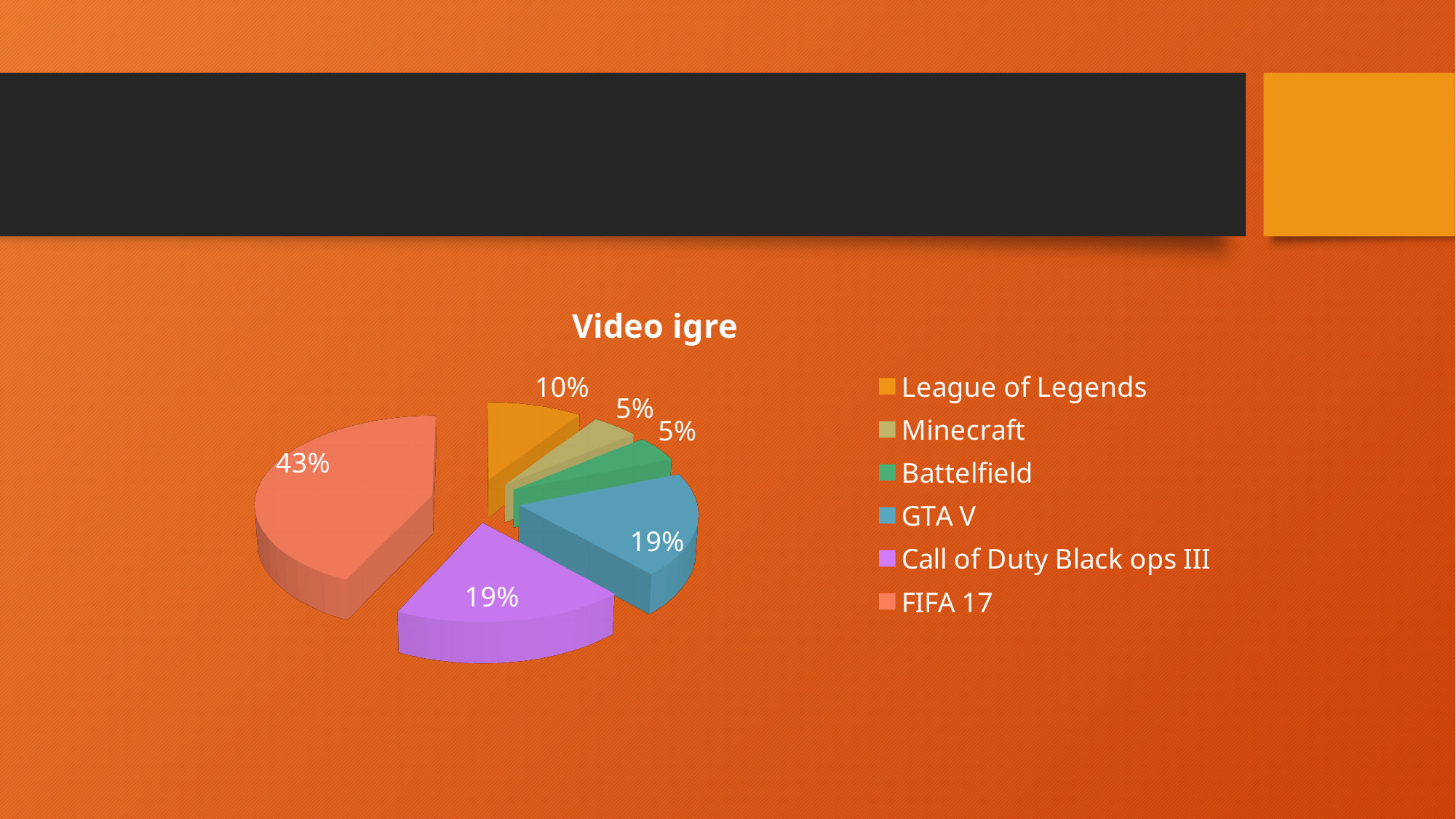
What percentage share does GTA V have? 19% What percentage share does Minecraft have? 5% What is the difference between the share for League of Legends and the share for Minecraft? 5% What percentage share does League of Legends have? 10% Which game has the largest share of the pie? FIFA 17 How many categories does the legend list? 6 What percentage share does FIFA 17 have? 43% What is the difference between the share for FIFA 17 and the share for GTA V? 24% Which has a larger share, League of Legends or Battlefield? League of Legends What type of chart is shown on the slide? Pie chart What is the title of the chart? Video igre What colour is the slice for Call of Duty Black ops III? Purple